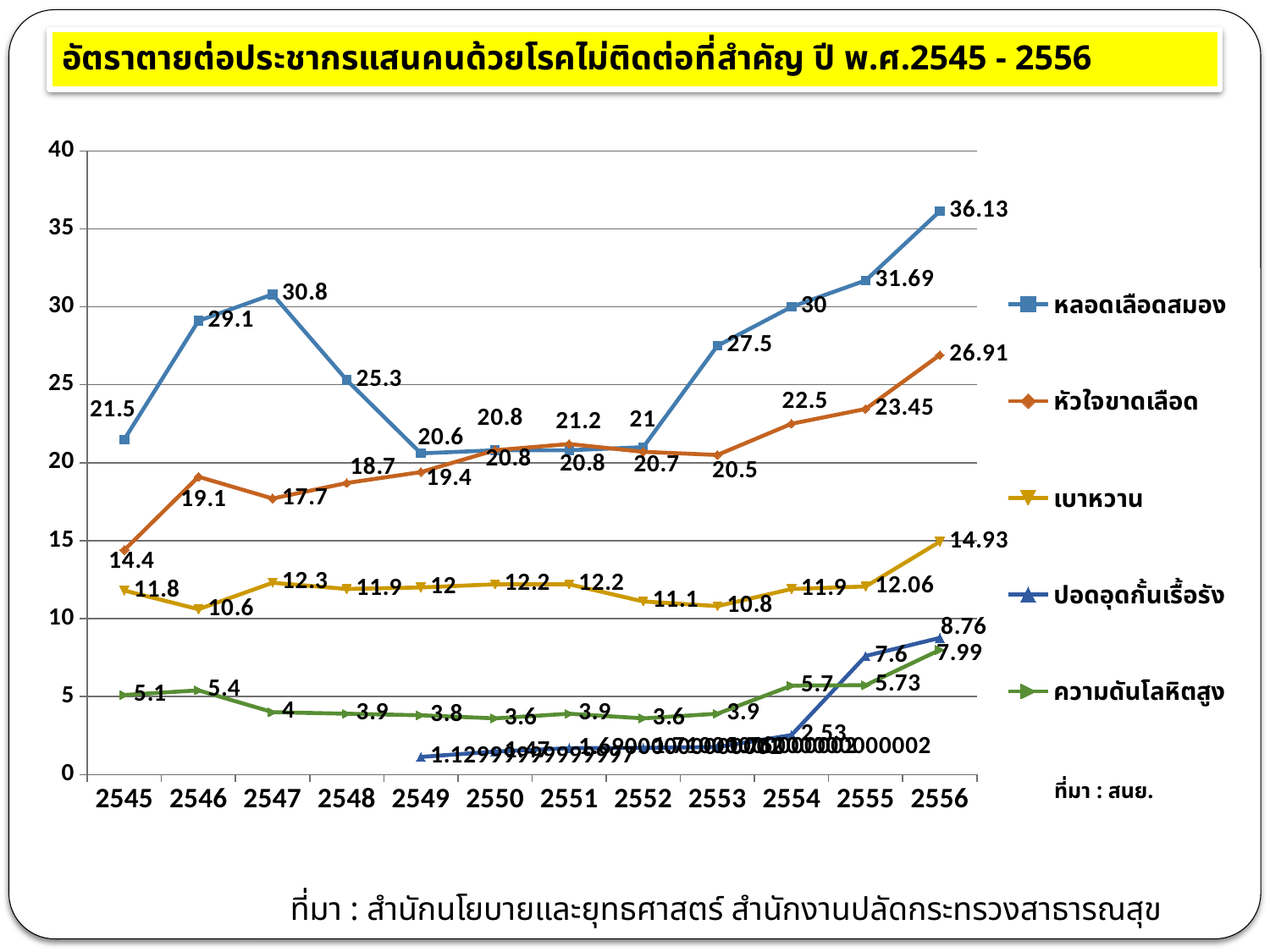
Does the value for หัวใจขาดเลือด rise or fall from 2553 to 2556? rise What is the value for หัวใจขาดเลือด in 2545? 14.4 What is the value for เบาหวาน in 2553? 10.8 Which is larger in 2556, the value for ปอดอุดกั้นเรื้อรัง or the value for ความดันโลหิตสูง? ปอดอุดกั้นเรื้อรัง How many years are shown on the x axis? 12 What is the value for ความดันโลหิตสูง in 2554? 5.7 How many series does the legend list? 5 What type of chart is shown on the slide? line chart What is the difference between the หลอดเลือดสมอง value in 2547 and in 2549? 10.2 In which year is the value for หลอดเลือดสมอง highest? 2556 What is the value for หลอดเลือดสมอง in 2556? 36.13 In which year is the value for หัวใจขาดเลือด lowest? 2545